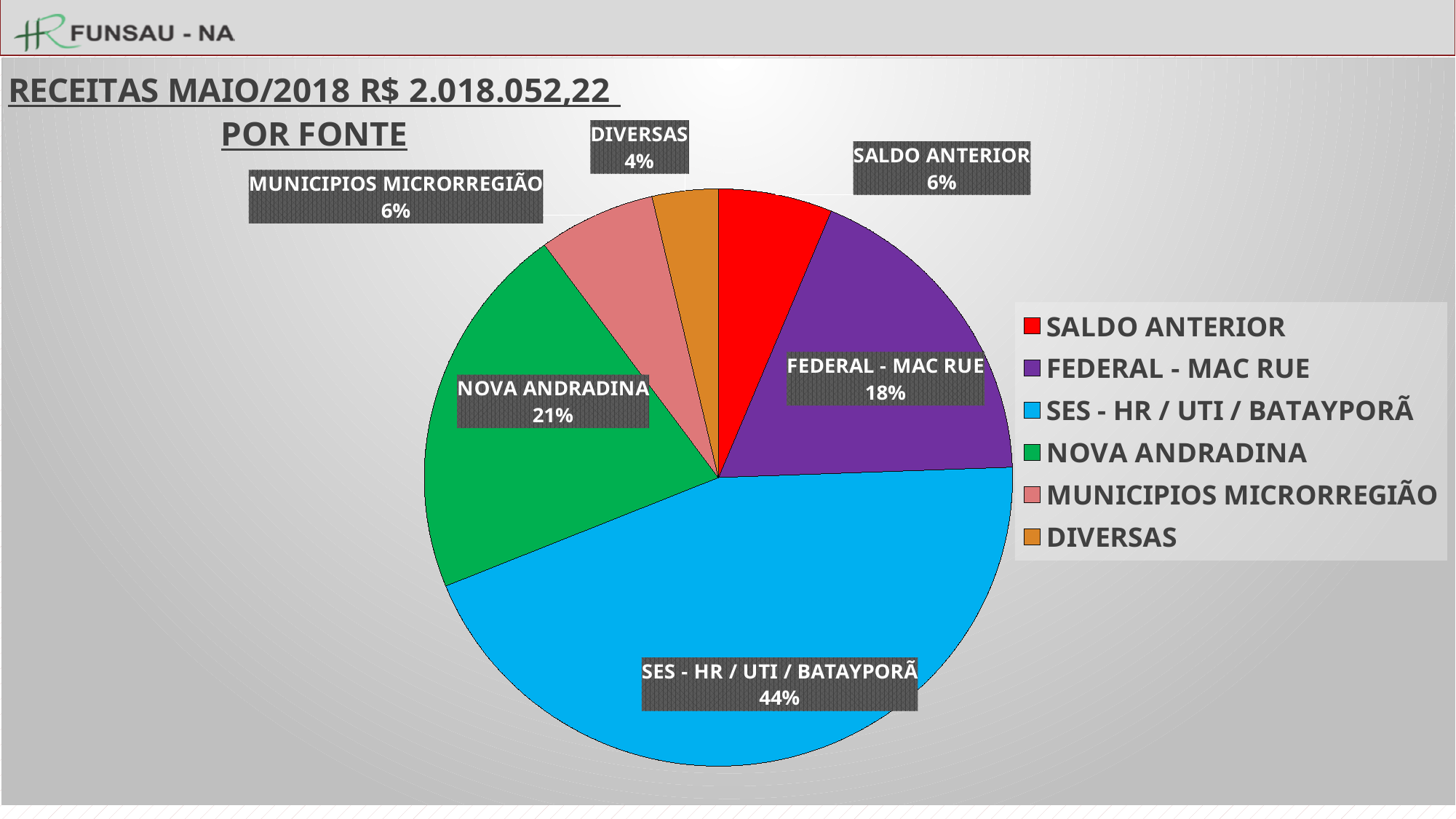
Which category has the largest slice of the pie? SES - HR / UTI / BATAYPORÃ What share of the pie does SES - HR / UTI / BATAYPORÃ represent? 44% What total amount is stated in the chart title for May 2018? R$ 2.018.052,22 What is the value shown for FEDERAL - MAC RUE? 18% Which category has the smallest slice of the pie? DIVERSAS Which is larger, the slice for FEDERAL - MAC RUE or the slice for SALDO ANTERIOR? FEDERAL - MAC RUE How many categories does the pie chart have? 6 What kind of chart is shown on the slide? pie chart What is the difference in percentage points between SES - HR / UTI / BATAYPORÃ and NOVA ANDRADINA? 23 What colour is the slice for NOVA ANDRADINA? green What is the value shown for DIVERSAS? 4% What is the value shown for NOVA ANDRADINA? 21%